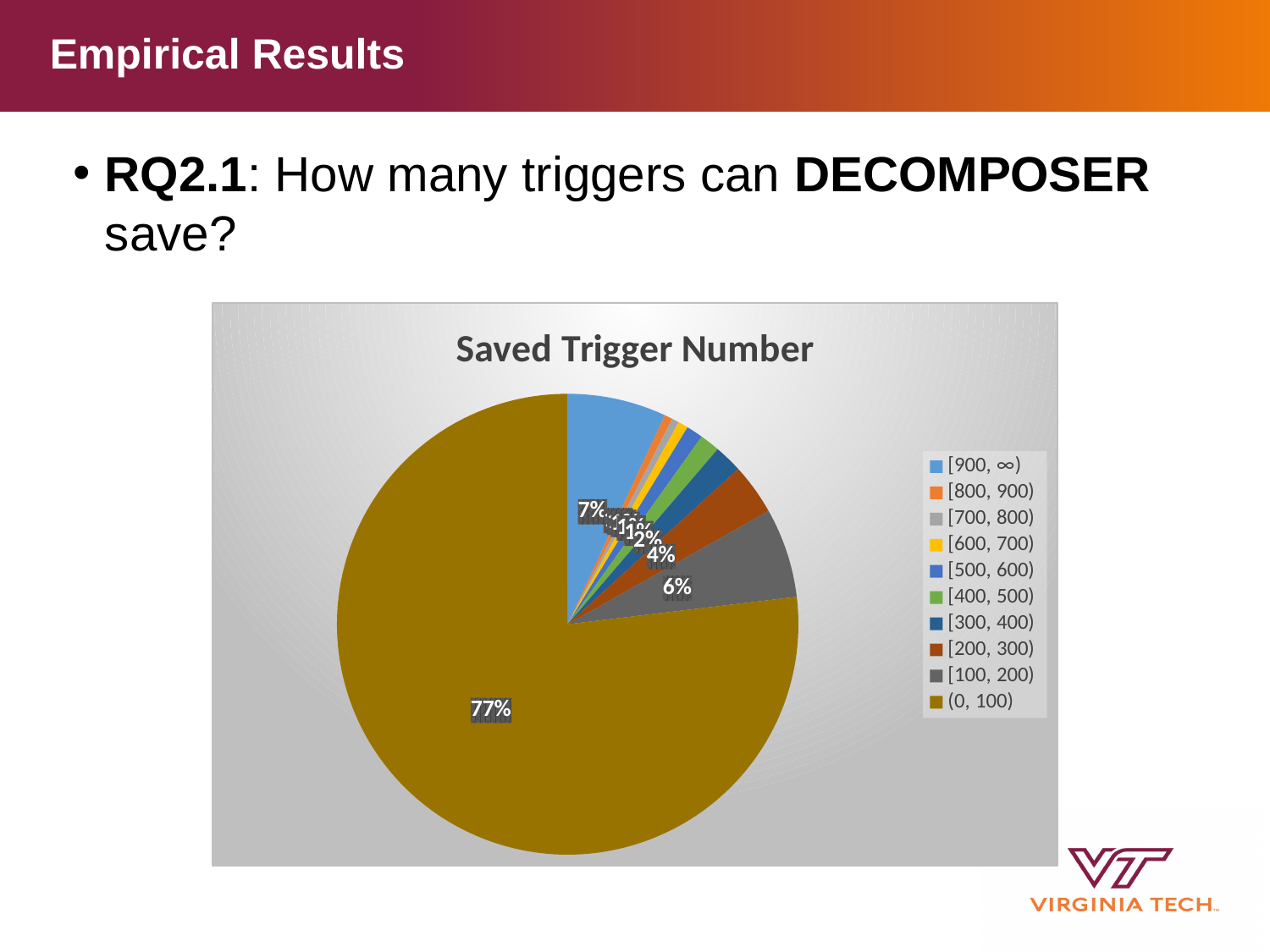
What percentage is shown for the [900, ∞) category? 7% What percentage is shown for the [200, 300) category? 4% Which slice is larger, [100, 200) or [200, 300)? [100, 200) What share of the pie does the (0, 100) category take? 77% What percentage is shown for the [100, 200) category? 6% What is the difference in percentage points between the (0, 100) slice and the [100, 200) slice? 71 Which legend entry is shown in light blue? [900, ∞) How many categories does the legend of the pie chart list? 10 What kind of chart is shown on the slide? pie chart What is the title of the chart? Saved Trigger Number Which slice is larger, [900, ∞) or [200, 300)? [900, ∞) Which category has the largest slice of the pie? (0, 100)